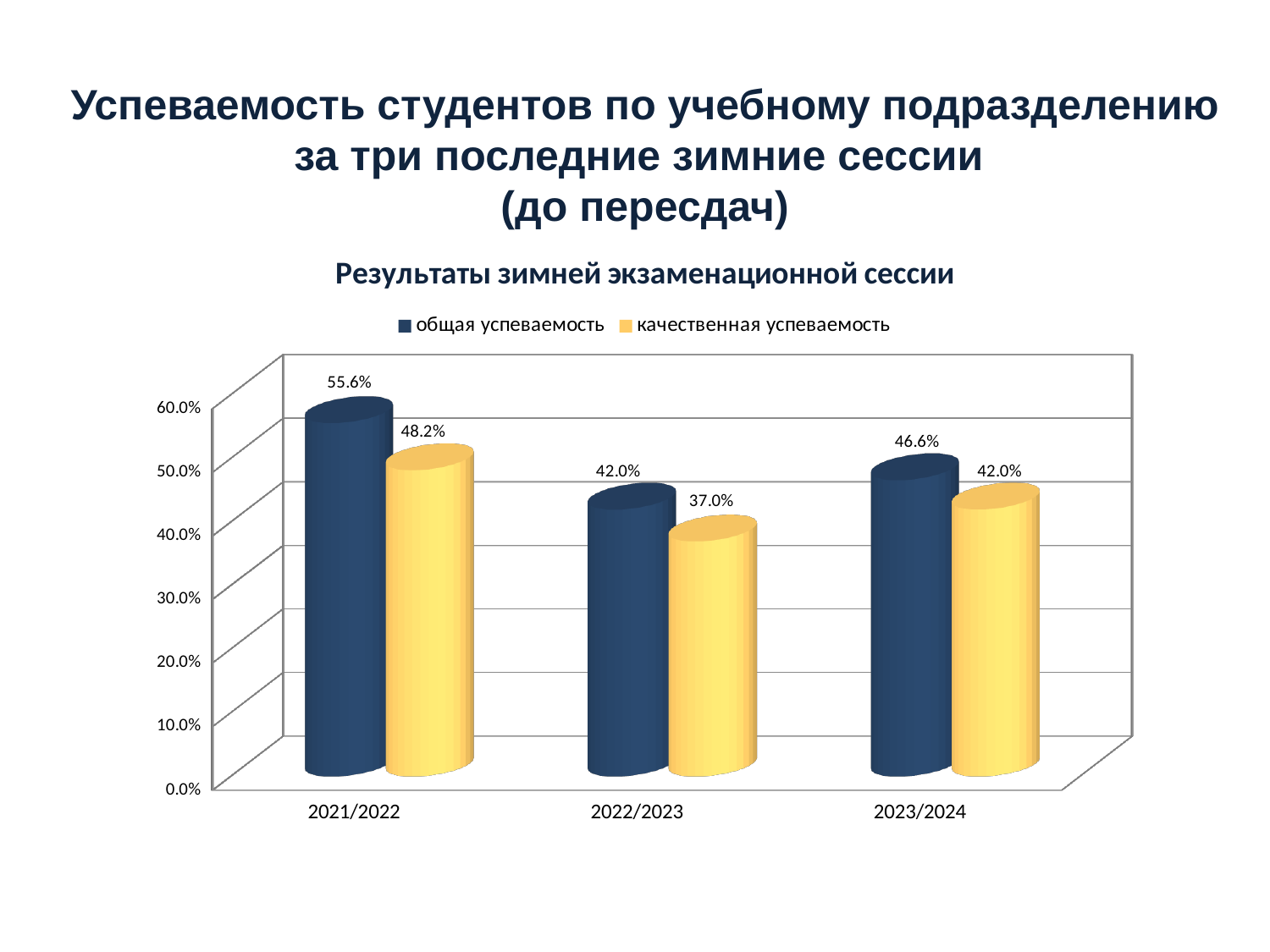
What is the value of качественная успеваемость for 2023/2024? 42.0% What is the difference between общая успеваемость and качественная успеваемость in 2021/2022? 7.4% What is the value of качественная успеваемость for 2022/2023? 37.0% How many series does the legend list? 2 Which academic year has the lowest качественная успеваемость? 2022/2023 Which is larger: общая успеваемость in 2022/2023 or качественная успеваемость in 2023/2024? They are equal (42.0%) Which academic year has the highest общая успеваемость? 2021/2022 What kind of chart is shown on the slide? Bar chart What is the value of общая успеваемость for 2021/2022? 55.6% What is the title of the chart? Результаты зимней экзаменационной сессии What is the value of общая успеваемость for 2023/2024? 46.6% How many academic years are shown on the x axis? 3